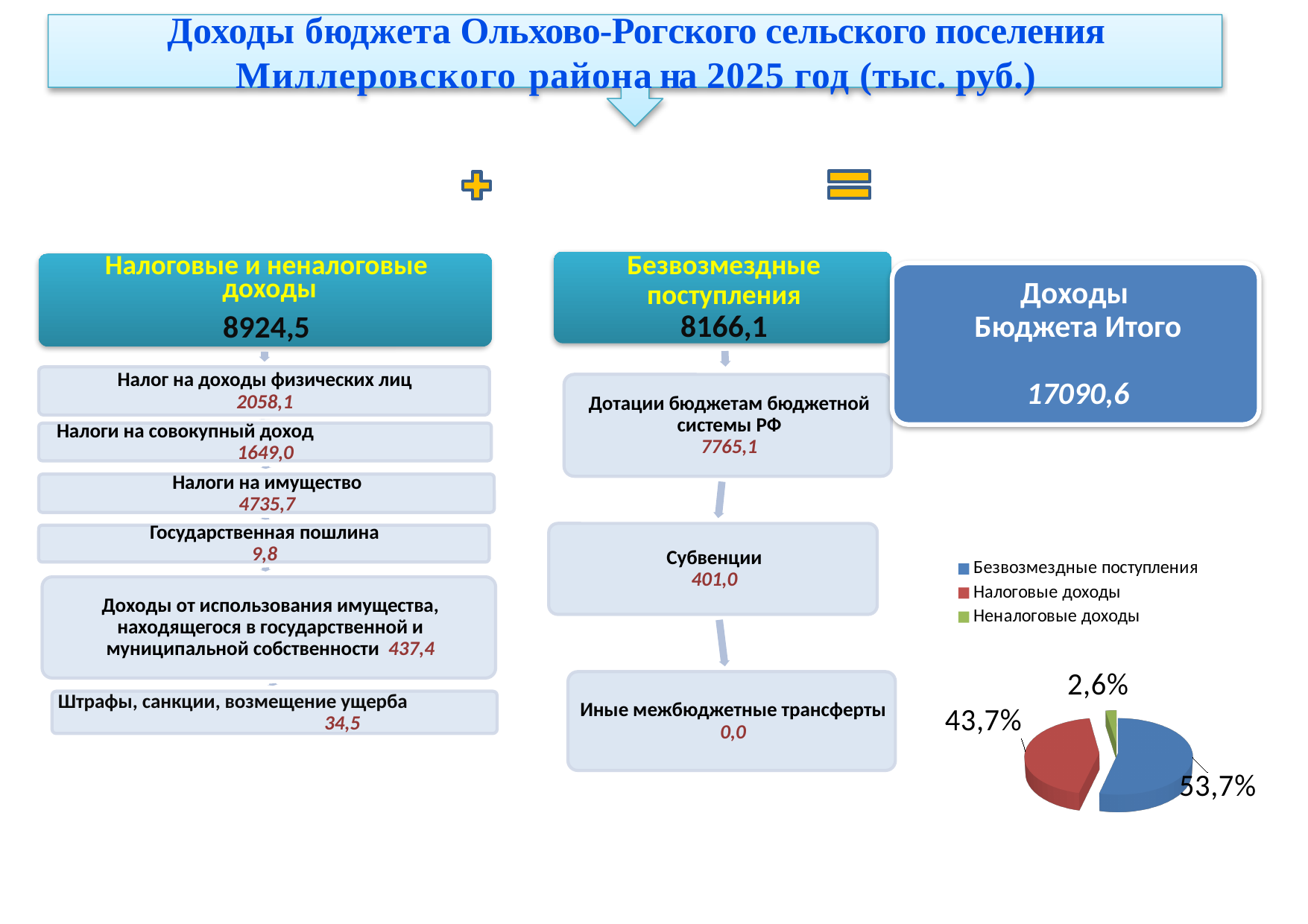
How many series does the pie chart's legend list? 3 What colour is the Безвозмездные поступления slice in the pie chart? blue What share of the pie chart is Неналоговые доходы? 2,6% Which slice of the pie chart is the smallest? Неналоговые доходы In the pie chart, which is larger: Налоговые доходы or Неналоговые доходы? Налоговые доходы Which slice of the pie chart is the largest? Безвозмездные поступления How many slices does the pie chart have? 3 In the pie chart, what is the difference in percentage points between Безвозмездные поступления and Налоговые доходы? 10,0 percentage points What share of the pie chart is Налоговые доходы? 43,7% What colour is the Налоговые доходы slice in the pie chart? red What kind of chart is shown on the slide? pie chart What share of the pie chart is Безвозмездные поступления? 53,7%